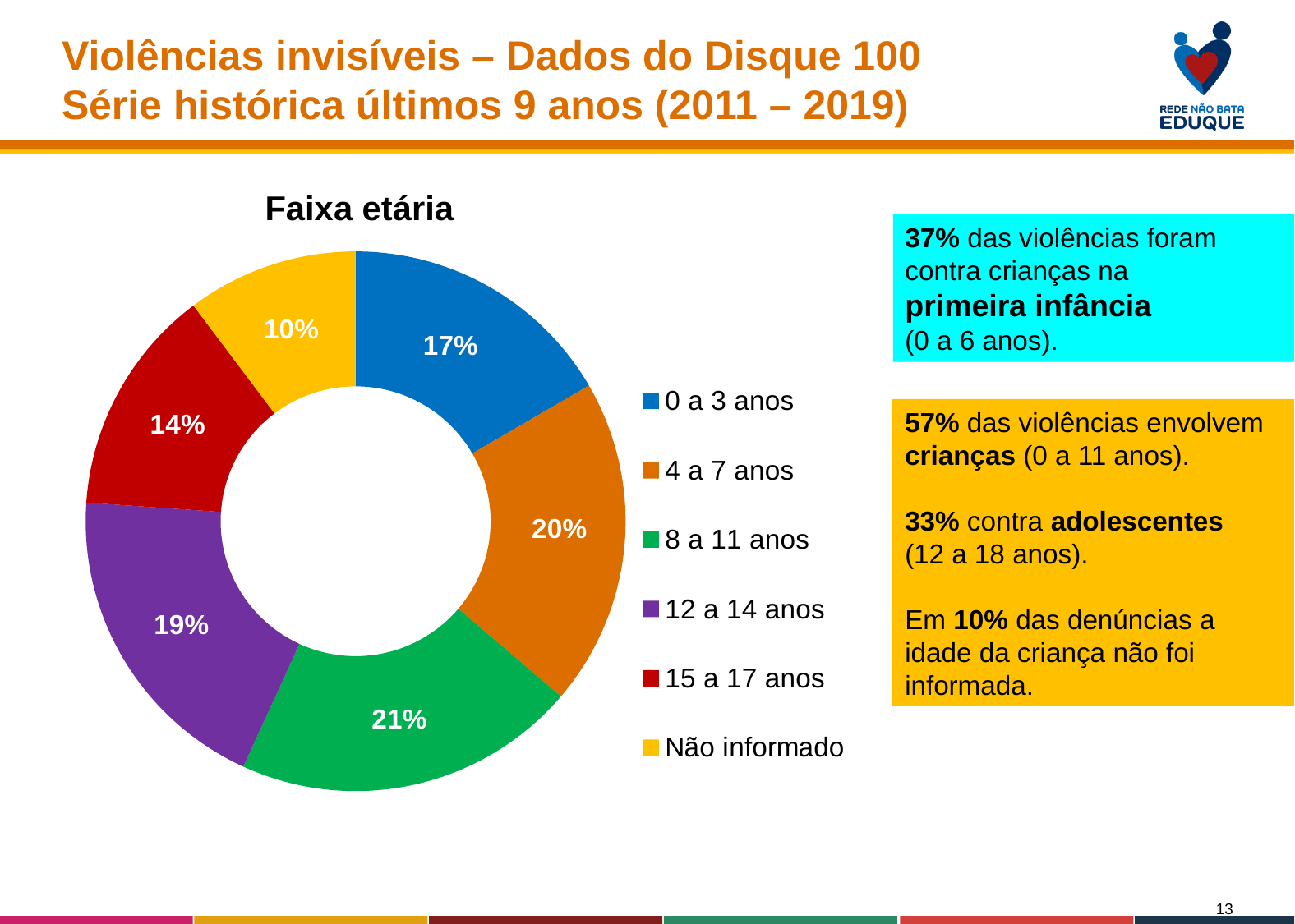
Which category has the smallest slice of the pie? Não informado What is the difference between the '8 a 11 anos' slice and the '15 a 17 anos' slice? 7% What is the value shown for '15 a 17 anos'? 14% What share of the pie is labelled 'Não informado'? 10% Which is larger, the '4 a 7 anos' slice or the '12 a 14 anos' slice? 4 a 7 anos What share of the pie does the '0 a 3 anos' slice represent? 17% What is the value shown for '4 a 7 anos'? 20% Which age group has the largest slice of the pie? 8 a 11 anos What is the title of the chart? Faixa etária What is the value shown for '8 a 11 anos'? 21% How many categories does the pie chart show? 6 What is the value shown for '12 a 14 anos'? 19%